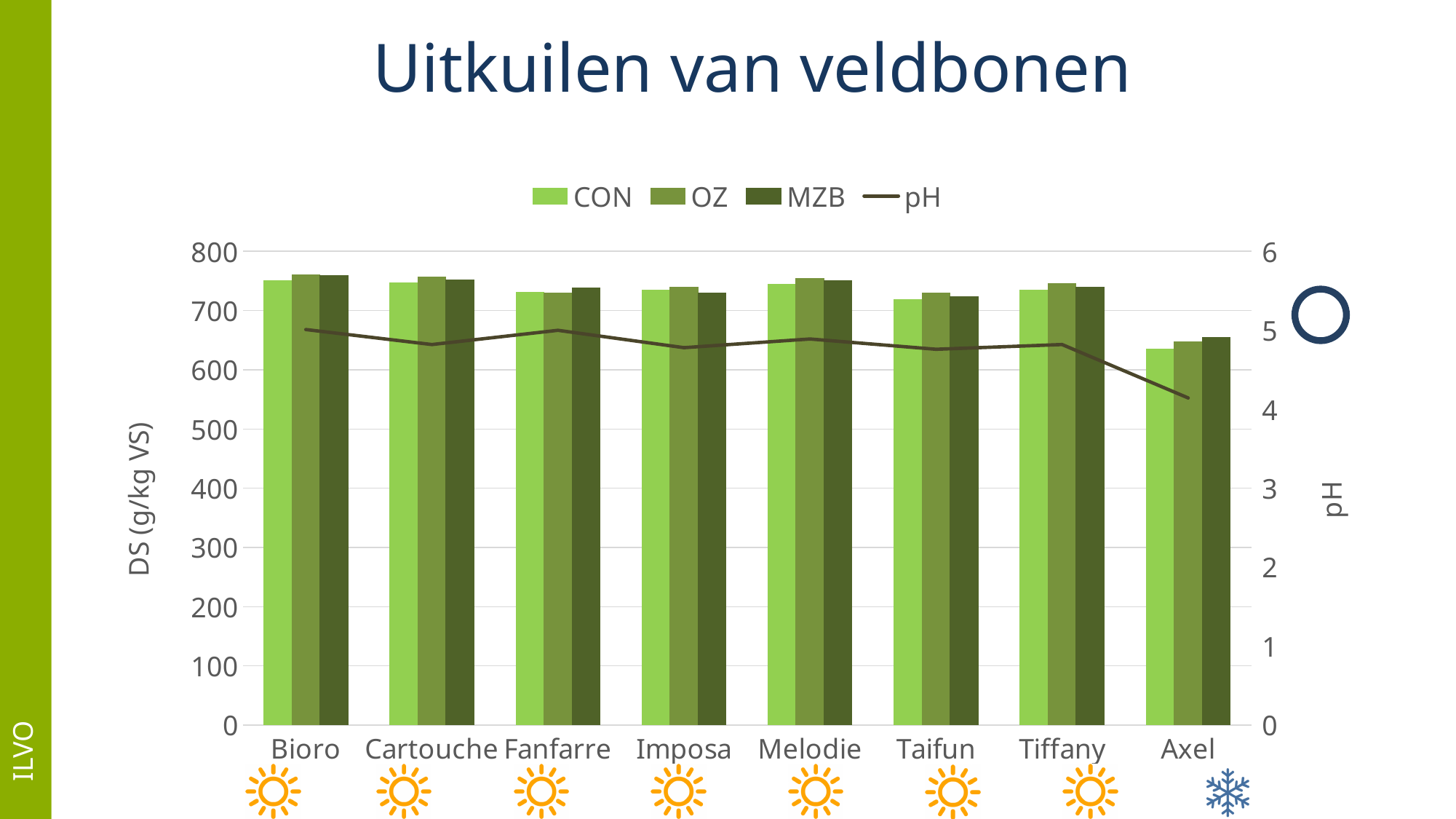
Which is larger, the CON value for Bioro or the CON value for Axel? Bioro Which category has the lowest pH value? Axel What kind of chart is this? Bar chart with a line (pH) Is the CON value for Axel greater or less than 700? less Is the OZ value for Bioro greater or less than 700? greater What is the title of the chart? Uitkuilen van veldbonen How many series does the legend list? 4 Which category has the lowest DS values for all three bar series? Axel Is the pH value for Axel greater or less than 5? less What is the label of the left vertical axis? DS (g/kg VS) How many categories are shown on the x axis? 8